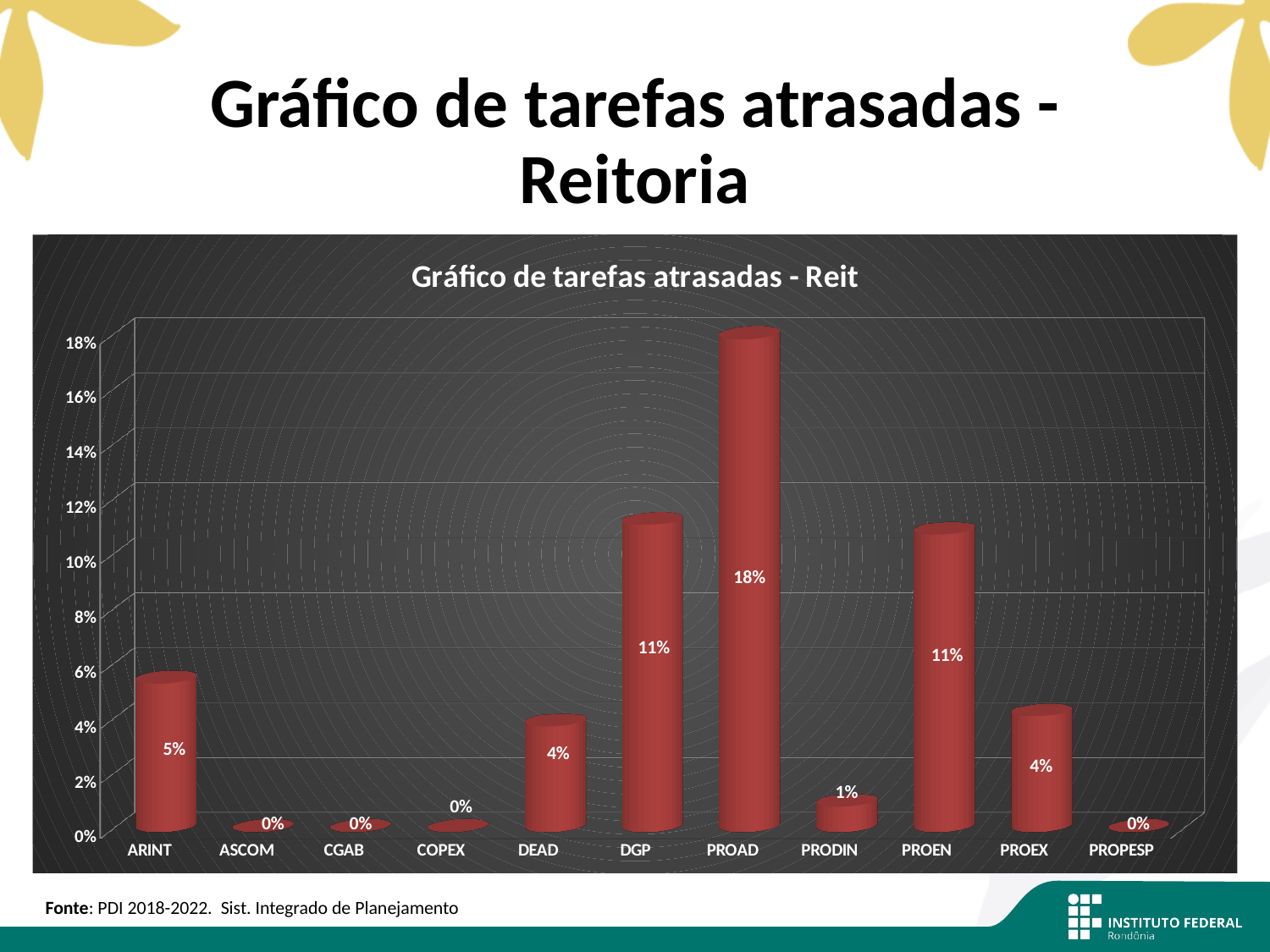
How many categories have a value of 0%? 4 What is the value for PRODIN? 1% Which category has the highest value? PROAD How many categories are shown on the x axis? 11 What is the difference between the values for PROAD and DGP? 7% Which is larger, the value for ARINT or the value for PROEX? ARINT What is the value for ARINT? 5% What is the value for DGP? 11% What is the difference between the values for ARINT and DEAD? 1% What is the value for PROAD? 18% What type of chart is shown? Bar chart Is the value for PROAD greater or less than 16%? greater